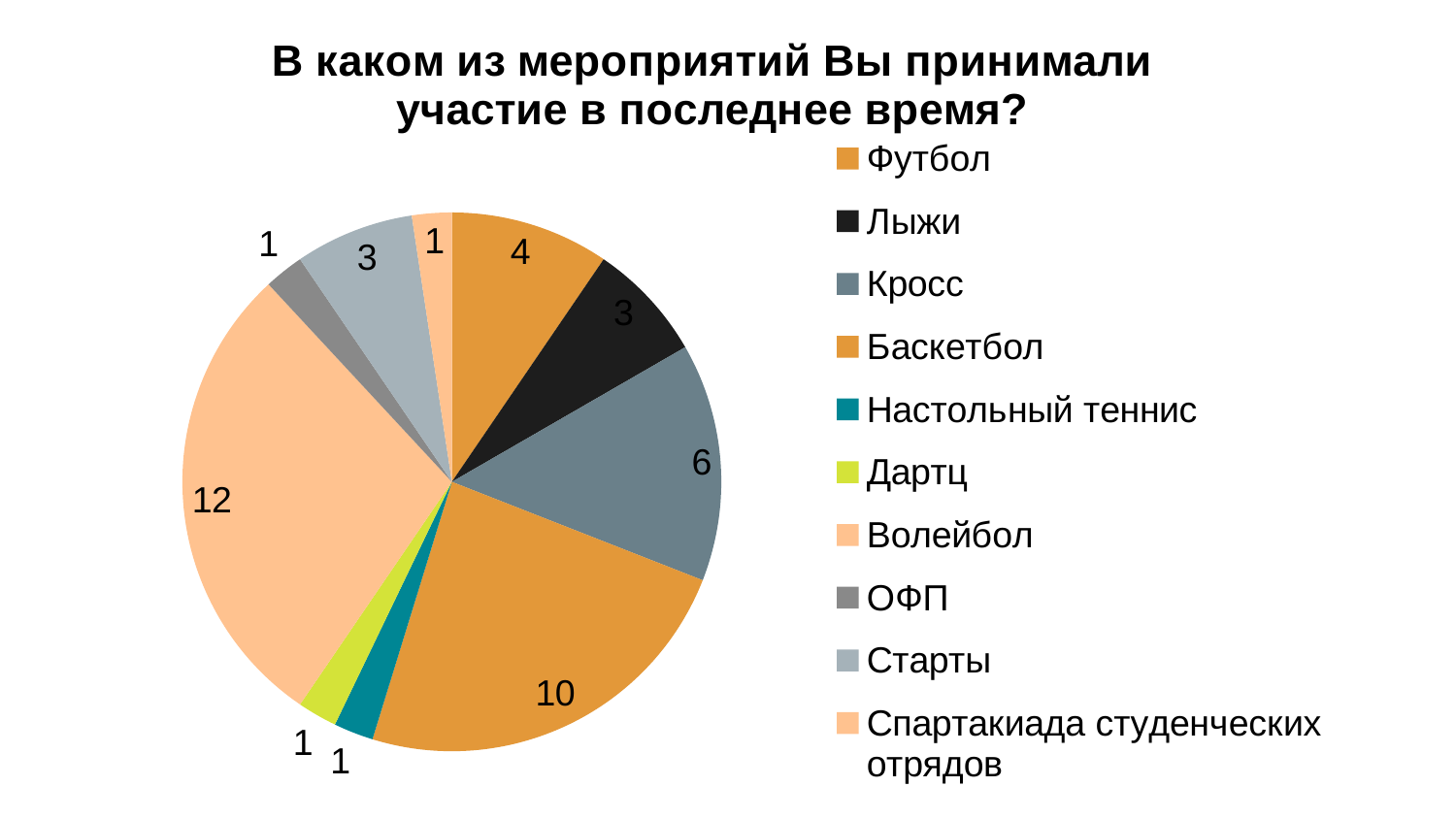
Which is larger, the value for Кросс or the value for Футбол? Кросс What is the difference between the values for Волейбол and Баскетбол? 2 Which category has the largest slice? Волейбол What is the value for Футбол? 4 What is the value for Баскетбол? 10 What is the value for Волейбол? 12 What is the total of all the values in the pie chart? 42 How many categories does the pie chart have? 10 What is the title of the chart? В каком из мероприятий Вы принимали участие в последнее время? What is the value for Кросс? 6 What type of chart is shown on the slide? pie chart What is the value for Лыжи? 3